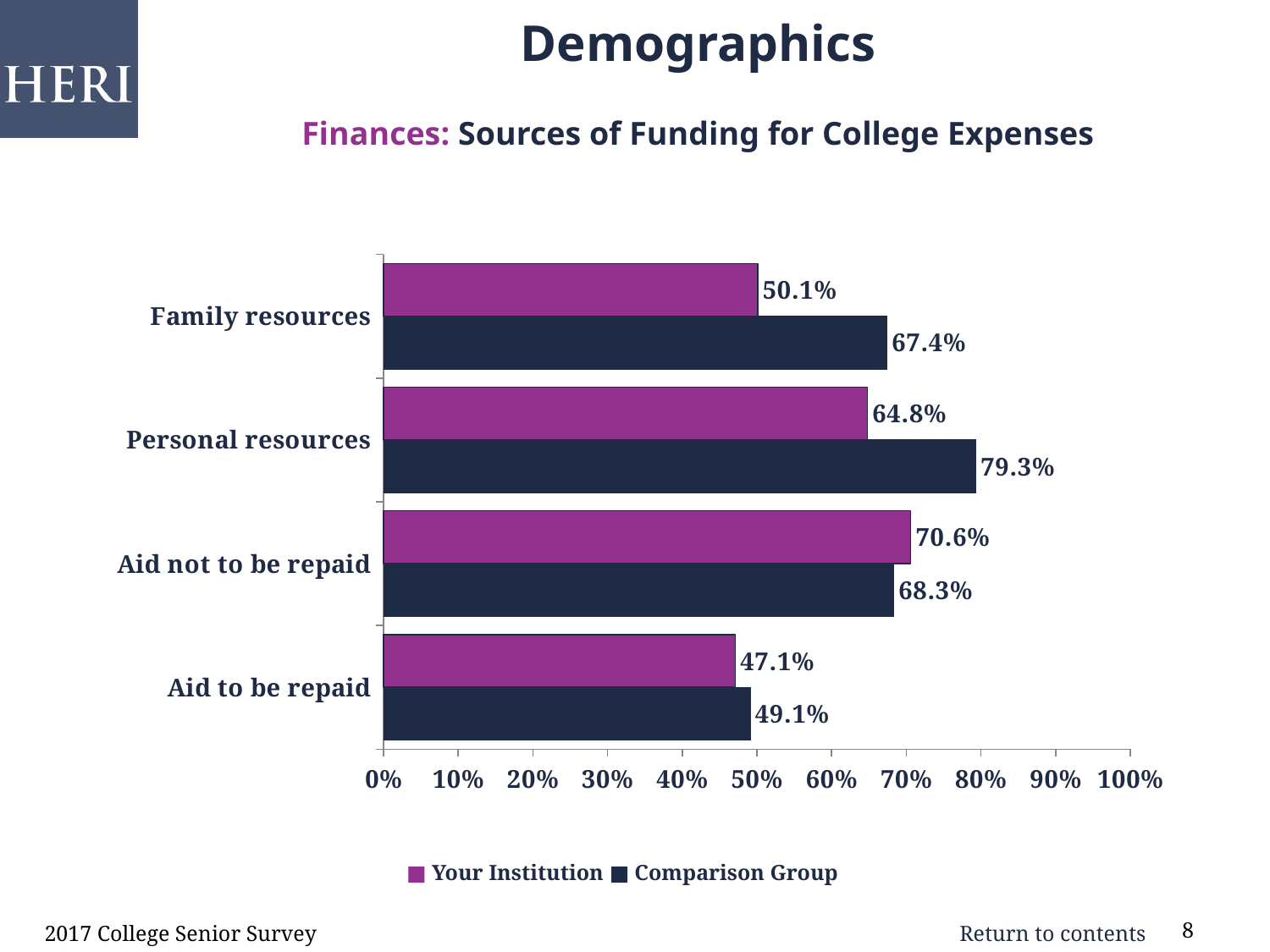
How many categories are shown on the chart? 4 What is the difference between the Comparison Group and Your Institution values for Family resources? 17.3% Is the Comparison Group value for Personal resources greater or less than 70%? greater Which category has the lowest value for Comparison Group? Aid to be repaid What is the value for Your Institution for Aid to be repaid? 47.1% For Aid not to be repaid, which series has the larger value, Your Institution or Comparison Group? Your Institution Which category has the highest value for Your Institution? Aid not to be repaid What is the value for Your Institution for Family resources? 50.1% What is the value for Comparison Group for Personal resources? 79.3% How many series does the legend list? 2 What kind of chart is shown on the slide? Bar chart Which colour represents the Comparison Group series? Dark navy